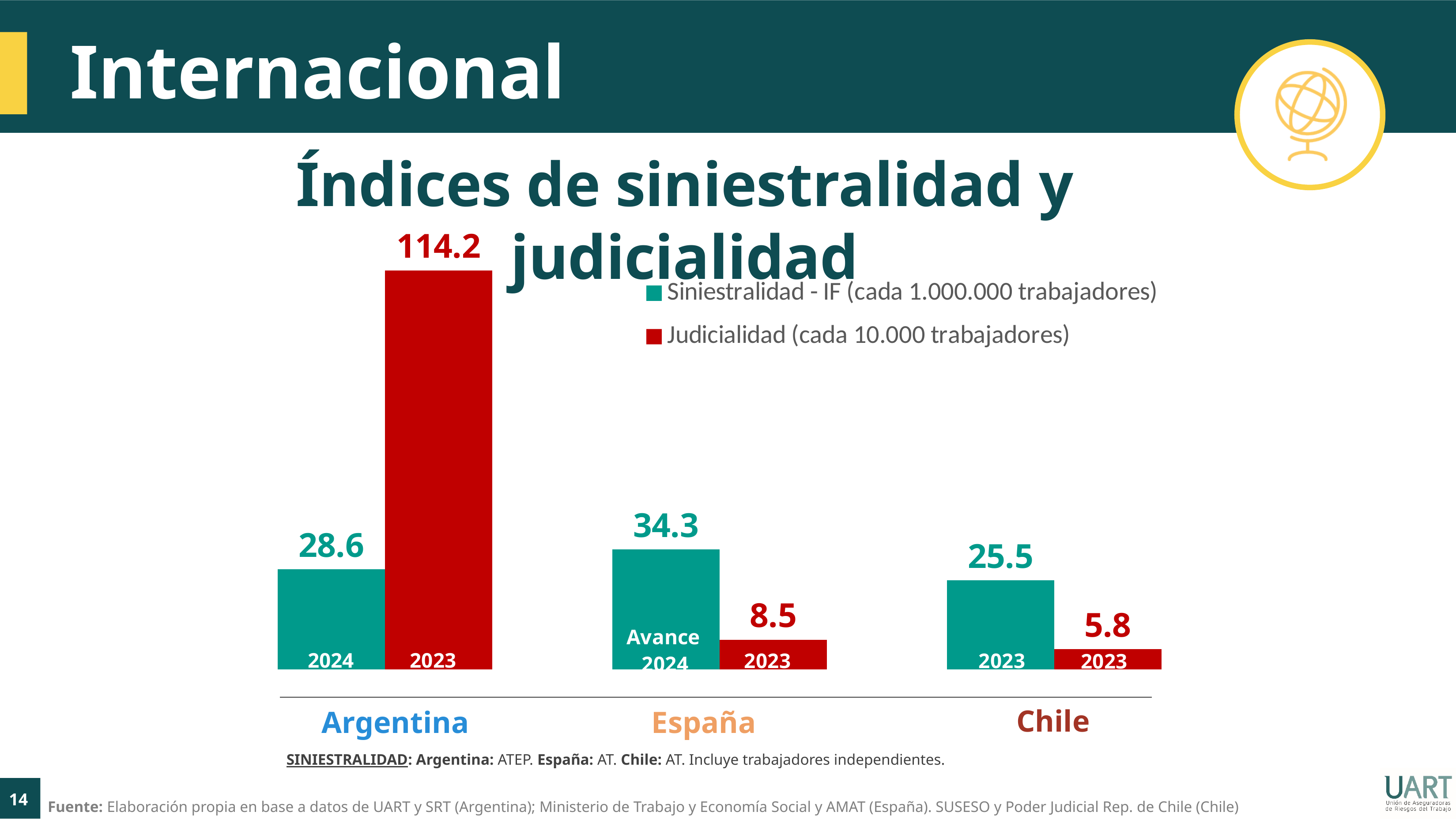
Which country has the lowest Siniestralidad - IF value? Chile Which is larger, the Siniestralidad - IF value for España or for Argentina? España What colour are the Judicialidad bars? Red What is the difference between the Judicialidad values for España and Chile? 2.7 What is the Judicialidad value for Chile? 5.8 How many countries are shown on the x axis? 3 How many series does the legend list? 2 What is the Judicialidad value for Argentina? 114.2 What is the Siniestralidad - IF value for Argentina? 28.6 Which country has the highest Judicialidad value? Argentina What kind of chart is shown on the slide? Bar chart What is the Siniestralidad - IF value for España? 34.3